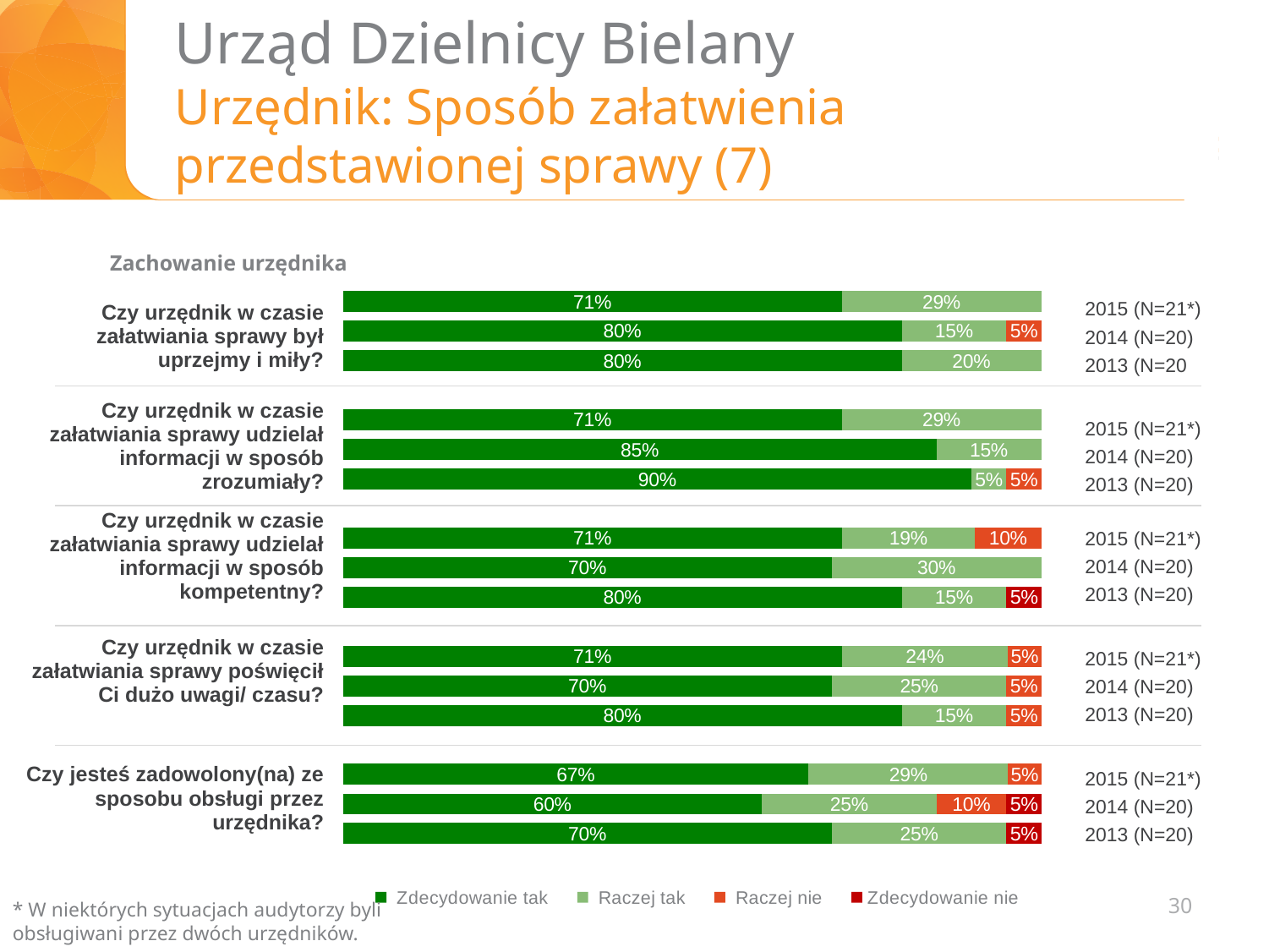
How many series does the legend list? 4 In the chart for "Czy urzędnik w czasie załatwiania sprawy udzielał informacji w sposób zrozumiały?", what is the "Zdecydowanie tak" value for 2013 (N=20)? 90% In the chart for "Czy urzędnik w czasie załatwiania sprawy udzielał informacji w sposób zrozumiały?", which year has the highest "Zdecydowanie tak" value? 2013 (N=20) In the chart for "Czy urzędnik w czasie załatwiania sprawy poświęcił Ci dużo uwagi/ czasu?", what is the difference between the "Zdecydowanie tak" values for 2013 (N=20) and 2015 (N=21*)? 9% In the chart for "Czy urzędnik w czasie załatwiania sprawy udzielał informacji w sposób kompetentny?", what is the "Raczej nie" value for 2015 (N=21*)? 10% In the chart for "Czy jesteś zadowolony(na) ze sposobu obsługi przez urzędnika?", which year has the lowest "Zdecydowanie tak" value? 2014 (N=20) Which legend entry is shown in dark red? Zdecydowanie nie In the chart for "Czy jesteś zadowolony(na) ze sposobu obsługi przez urzędnika?", what is the "Zdecydowanie tak" value for 2014 (N=20)? 60% In the chart for "Czy urzędnik w czasie załatwiania sprawy był uprzejmy i miły?", what is the "Zdecydowanie tak" value for 2015 (N=21*)? 71% In the chart for "Czy urzędnik w czasie załatwiania sprawy był uprzejmy i miły?", how many years (bars) are shown? 3 In the chart for "Czy urzędnik w czasie załatwiania sprawy udzielał informacji w sposób kompetentny?", which is larger: the "Raczej tak" value for 2014 (N=20) or for 2013 (N=20)? 2014 (N=20) What kind of chart is used on this slide? Stacked bar chart